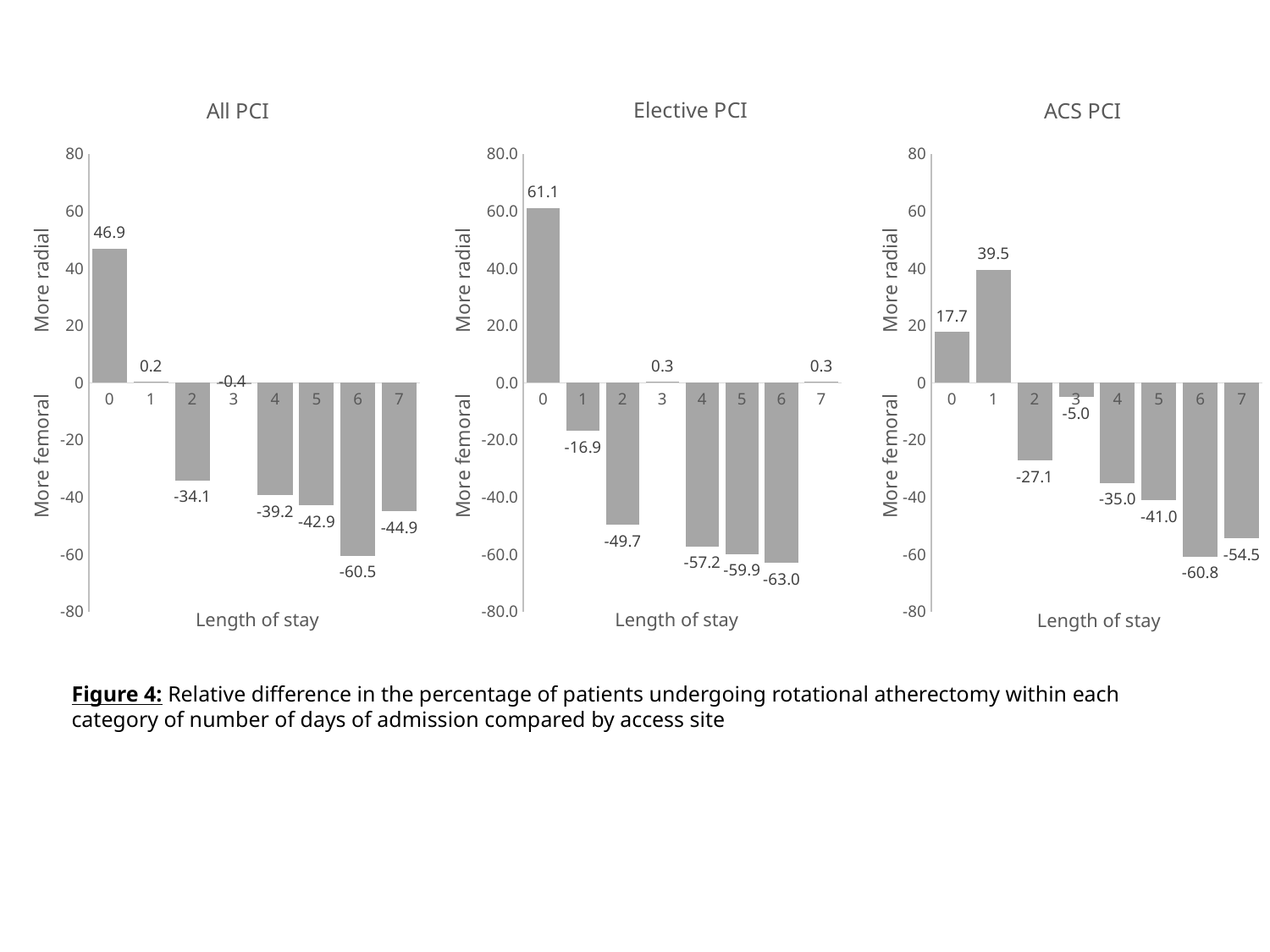
In the Elective PCI chart, is the value for length of stay 6 greater or less than -60? less In the All PCI chart, which length of stay has the lowest value? 6 In the ACS PCI chart, what is the value for length of stay 1? 39.5 What is the x-axis title of the All PCI chart? Length of stay In the All PCI chart, what is the value for length of stay 0? 46.9 In the Elective PCI chart, how many length-of-stay categories are plotted? 8 In the Elective PCI chart, which length of stay has the highest value? 0 In the ACS PCI chart, which length of stay has the lowest value? 6 What type of chart is the ACS PCI chart? Bar chart In the Elective PCI chart, what is the value for length of stay 2? -49.7 In the ACS PCI chart, which is larger, the value for length of stay 0 or length of stay 1? Length of stay 1 In the All PCI chart, what is the difference between the values for length of stay 0 and length of stay 6? 107.4